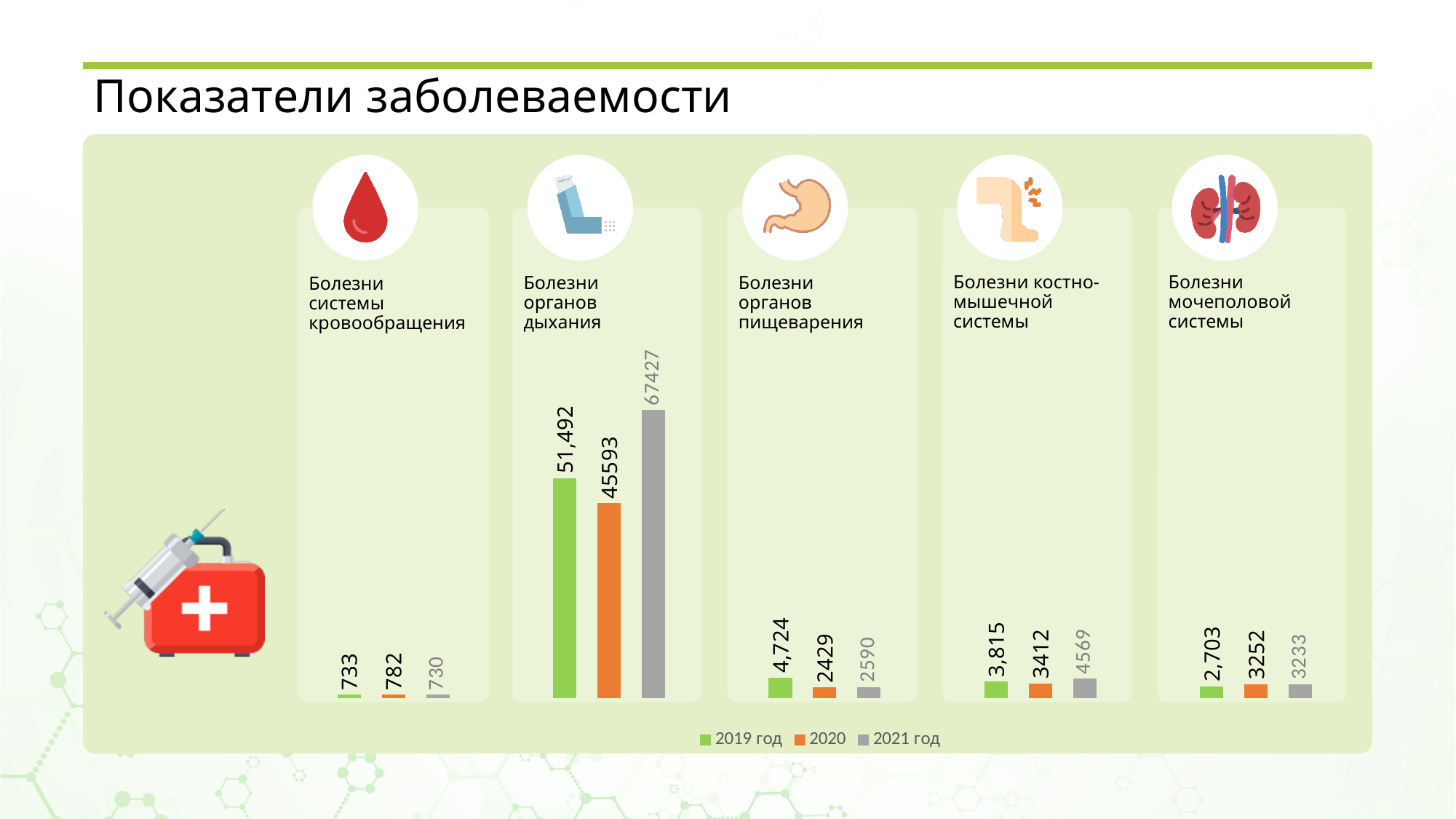
What is the 2019 год value for Болезни органов дыхания? 51,492 What is the 2020 value for Болезни мочеполовой системы? 3252 What kind of chart is shown on the slide? Bar chart How many disease categories are shown in the chart? 5 What is the 2021 год value for Болезни костно-мышечной системы? 4569 Which category has the lowest 2019 год value? Болезни системы кровообращения Which category has the highest 2021 год value? Болезни органов дыхания Which colour represents 2020 in the legend? Orange What is the difference between the 2021 год and 2020 values for Болезни органов дыхания? 21834 What is the 2021 год value for Болезни системы кровообращения? 730 Which is larger for Болезни органов пищеварения: the 2019 год value or the 2020 value? 2019 год How many series does the legend list? 3